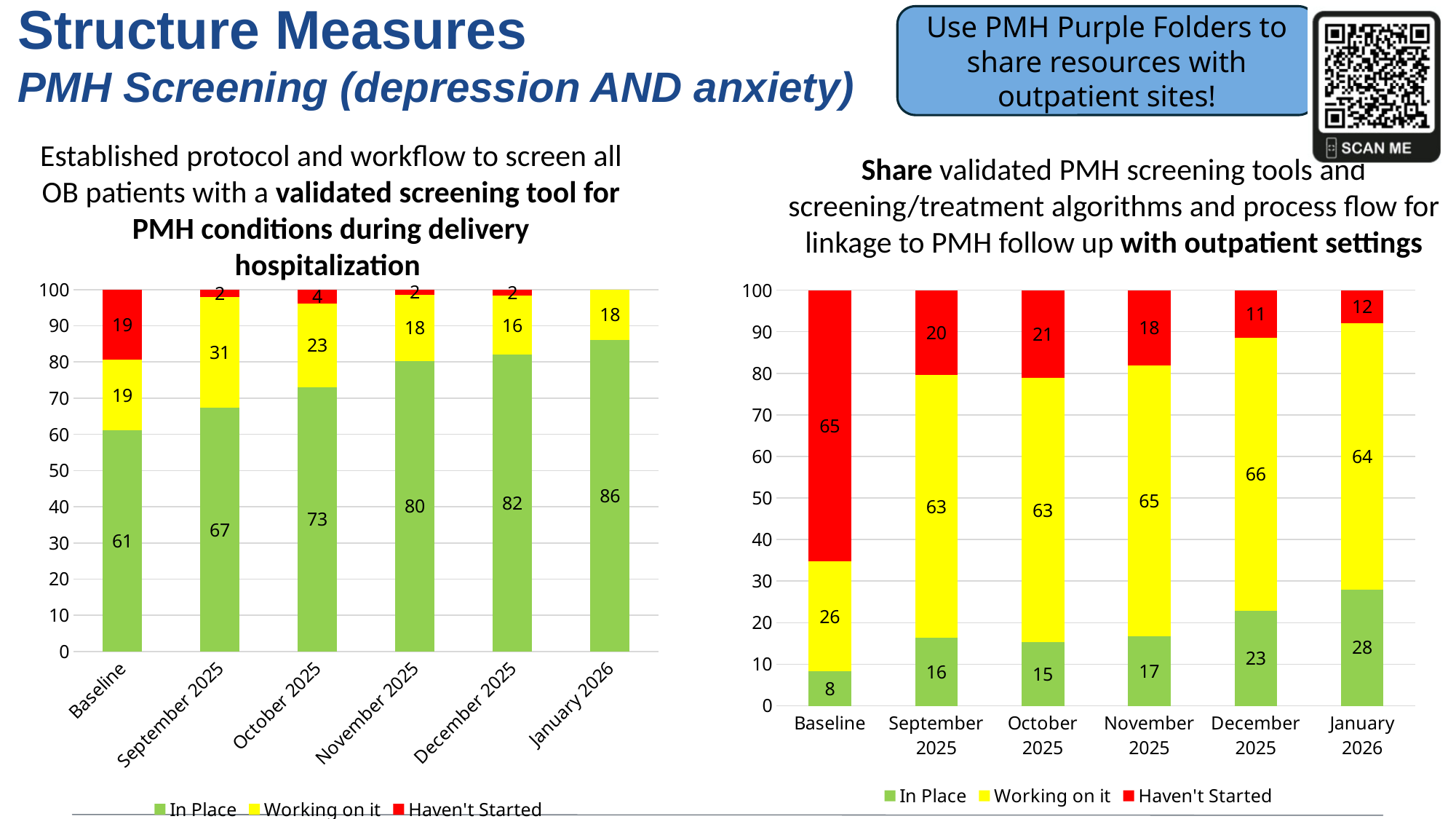
In the right chart, what is the Haven't Started value for Baseline? 65 How many categories are shown on the x axis of the right chart? 6 In the left chart, what is the difference between the In Place values for January 2026 and Baseline? 25 In the right chart, which category has the lowest In Place value? Baseline In the right chart, what is the total of the stacked bar for Baseline? 99 In the right chart, what is the Working on it value for December 2025? 66 In the left chart, what is the In Place value for October 2025? 73 What kind of chart is the right chart? Stacked bar chart In the left chart, which category has the highest In Place value? January 2026 In the right chart, does the In Place value rise or fall from September 2025 to January 2026? Rise How many series does the legend of the left chart list? 3 In the right chart, which is larger: the Haven't Started value for October 2025 or for November 2025? October 2025